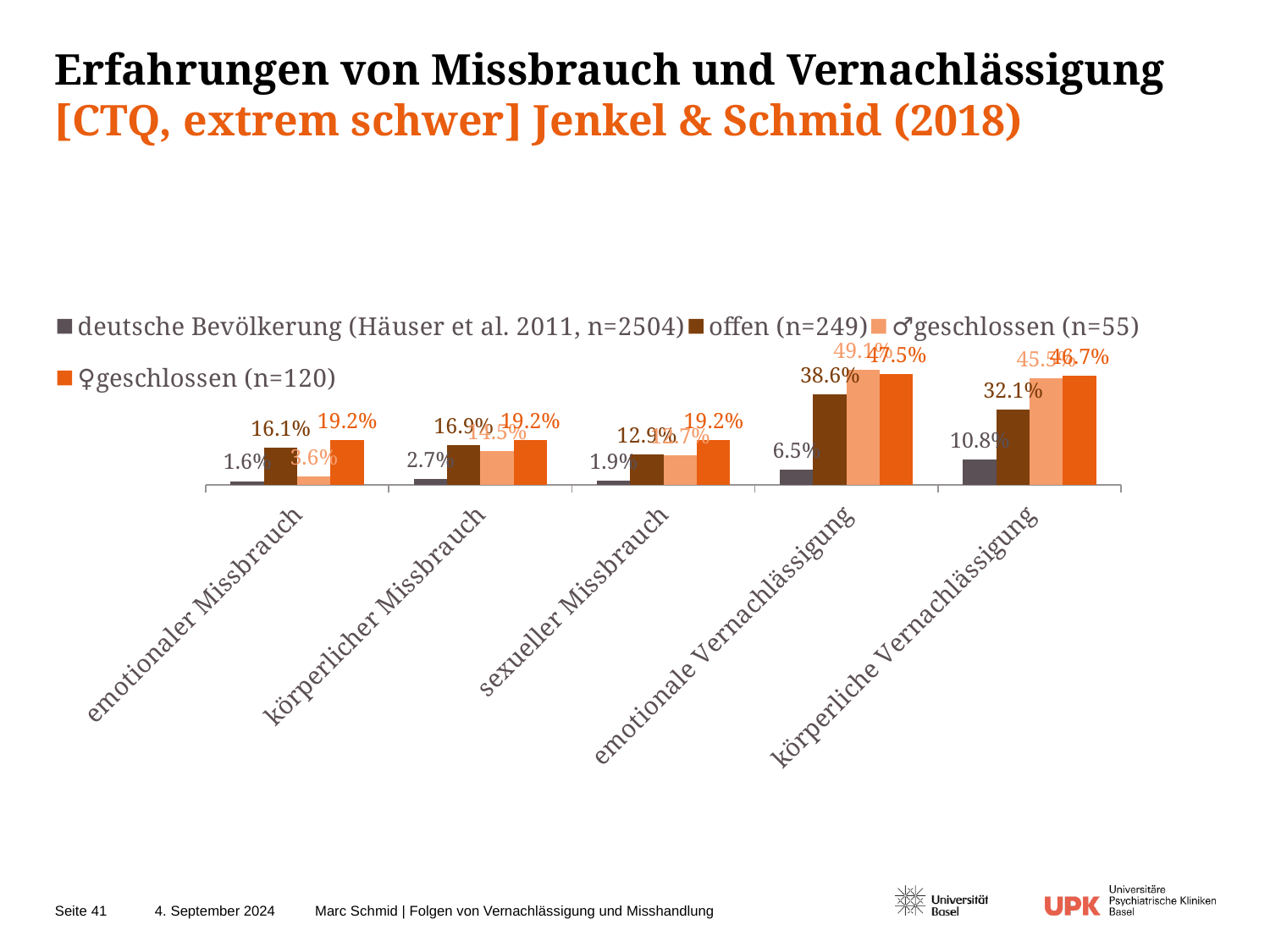
How many series does the legend list? 4 For the deutsche Bevölkerung series, which category has the lowest value? emotionaler Missbrauch What kind of chart is shown on the slide? bar chart What is the value for deutsche Bevölkerung (Häuser et al. 2011, n=2504) for emotionaler Missbrauch? 1.6% How many categories are shown on the x axis of the chart? 5 What is the value for ♀geschlossen (n=120) for körperliche Vernachlässigung? 46.7% For körperliche Vernachlässigung, what is the difference between the ♀geschlossen (n=120) value and the offen (n=249) value? 14.6% For emotionaler Missbrauch, what is the difference between the offen (n=249) value and the deutsche Bevölkerung value? 14.5% For emotionaler Missbrauch, which is larger: the offen (n=249) value or the ♂geschlossen (n=55) value? offen (n=249) What is the value for offen (n=249) for emotionale Vernachlässigung? 38.6% What is the value for ♂geschlossen (n=55) for körperlicher Missbrauch? 14.5% For the deutsche Bevölkerung series, which category has the highest value? körperliche Vernachlässigung